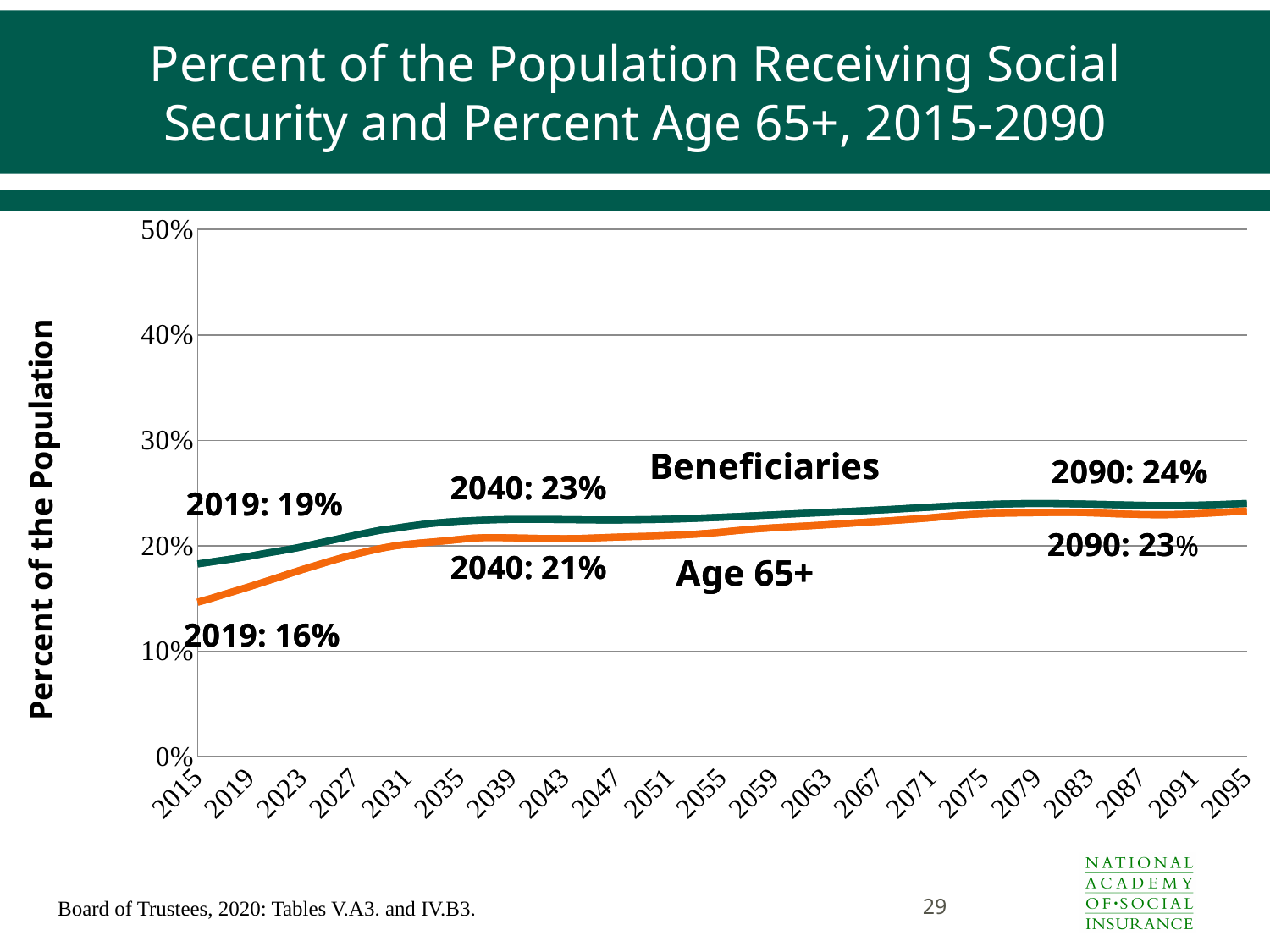
Is the value for Beneficiaries in 2015 greater or less than 20%? less What is the difference between the Beneficiaries value and the Age 65+ value in 2019? 3% What is the value for Beneficiaries in 2040? 23% What is the label of the vertical axis? Percent of the Population What is the value for Age 65+ in 2019? 16% Which series has the higher value in 2040, Beneficiaries or Age 65+? Beneficiaries What is the value for Beneficiaries in 2019? 19% What kind of chart is shown on the slide? line chart What is the value for Age 65+ in 2090? 23% What is the value for Beneficiaries in 2090? 24% What is the value for Age 65+ in 2040? 21% Does the Age 65+ line generally rise or fall from 2015 to 2095? rise